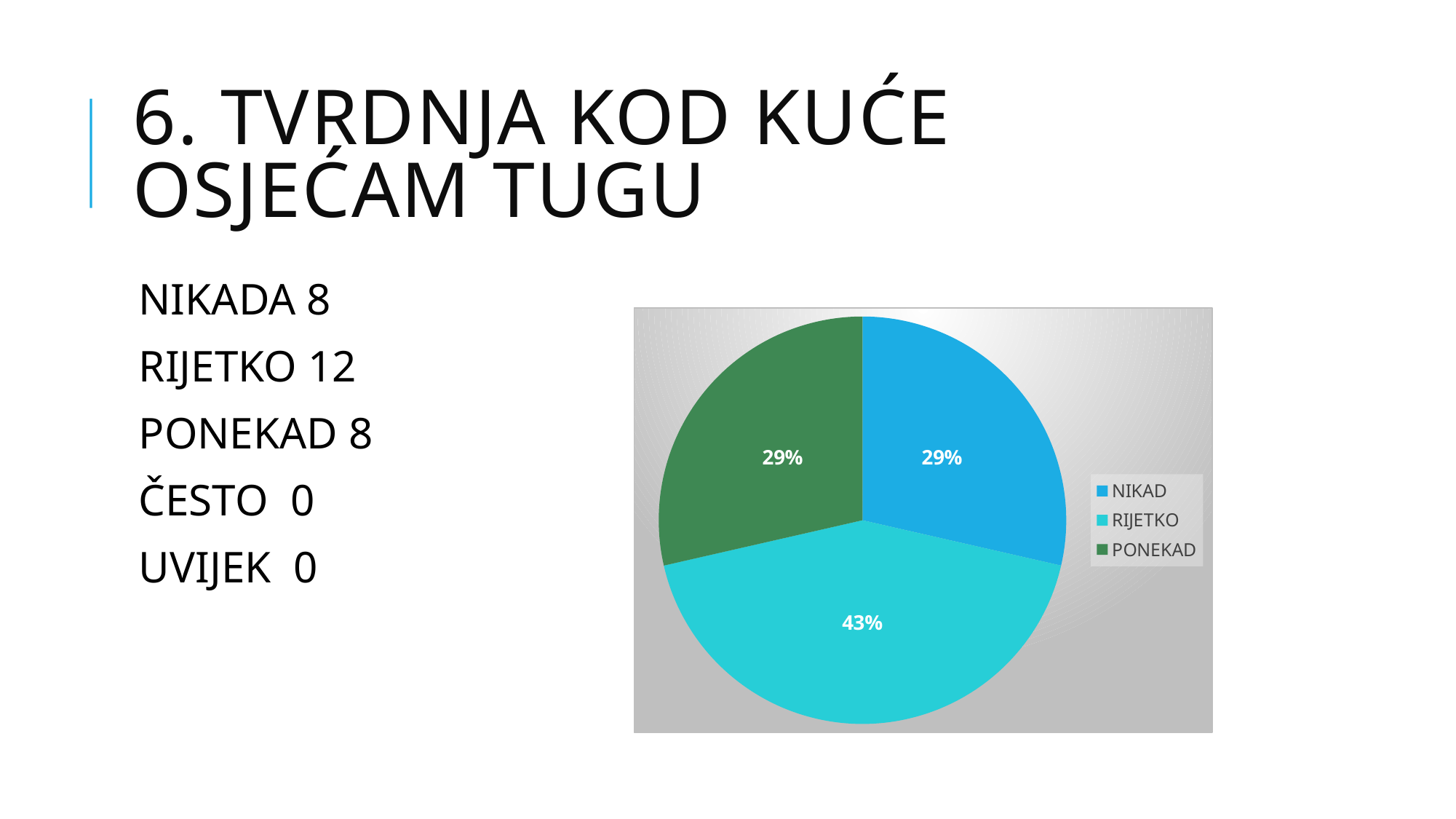
What percentage of the pie does the NIKAD slice represent? 29% What is the difference in percentage points between the RIJETKO slice and the PONEKAD slice? 14 What kind of chart is shown on the slide? pie chart Which category has the largest slice of the pie? RIJETKO How many entries does the legend list? 3 What percentage of the pie does the RIJETKO slice represent? 43% How many slices does the pie chart have? 3 What percentage of the pie does the PONEKAD slice represent? 29% What colour is the RIJETKO slice in the pie chart? light blue (cyan) Which slice is larger, RIJETKO or NIKAD? RIJETKO Which legend entry is shown in green? PONEKAD